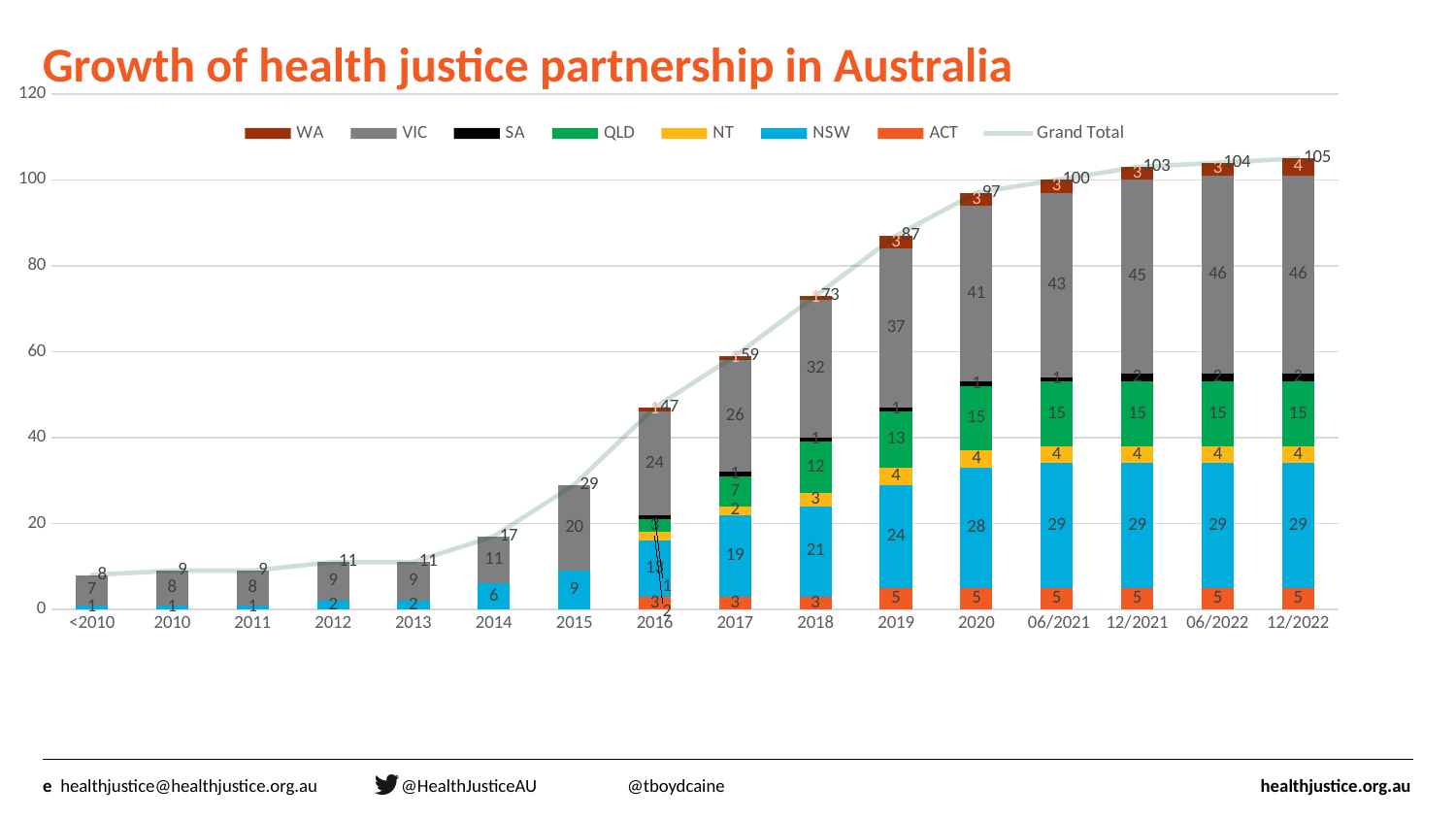
What is the NSW value for 2020? 28 Does the Grand Total rise or fall from <2010 to 12/2022? Rise What is the Grand Total value for 12/2022? 105 What kind of chart is shown on the slide? Stacked bar chart with a line In 2018, which is larger, the VIC value or the NSW value? VIC How many entries does the legend list? 8 What is the difference between the Grand Total for 2018 and the Grand Total for 2017? 14 What is the QLD value for 2018? 12 How many periods are shown on the x axis? 16 Which period has the highest Grand Total? 12/2022 Which period has the lowest Grand Total? <2010 What is the VIC value for 2019? 37